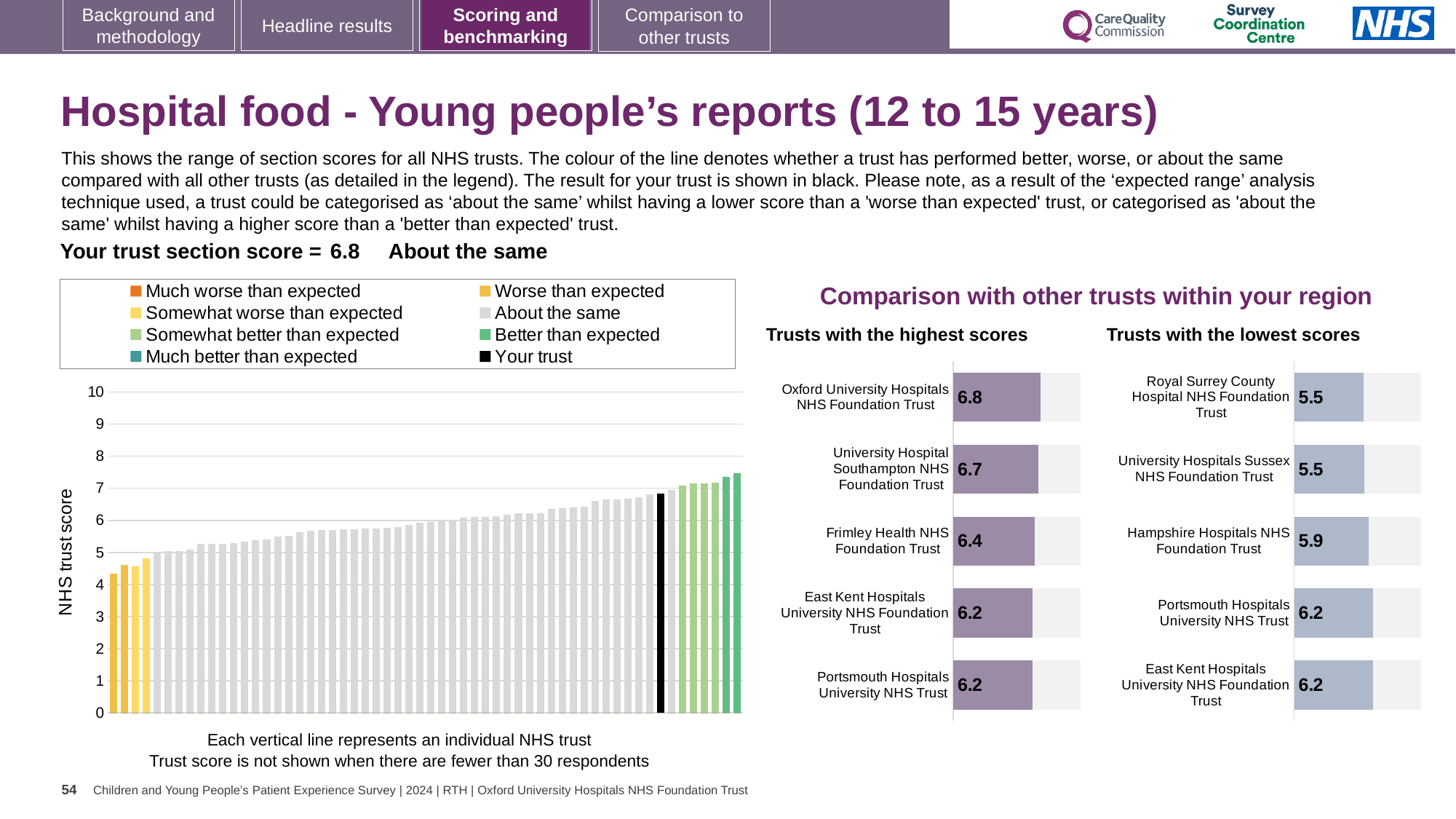
In the 'Trusts with the highest scores' chart, which trust has the highest score? Oxford University Hospitals NHS Foundation Trust How many trusts are shown in the 'Trusts with the lowest scores' chart? 5 In the NHS trust score chart on the left, is the value of the leftmost bar greater or less than 5? less In the 'Trusts with the lowest scores' chart, what is the difference between the scores of Hampshire Hospitals NHS Foundation Trust and Royal Surrey County Hospital NHS Foundation Trust? 0.4 What kind of chart is the NHS trust score chart on the left of the slide? Bar chart How many entries does the legend of the NHS trust score chart on the left list? 8 In the 'Trusts with the highest scores' chart, what is the difference between the scores of Oxford University Hospitals NHS Foundation Trust and Frimley Health NHS Foundation Trust? 0.4 In the NHS trust score chart on the left, what score does the black bar (your trust) represent? 6.8 In the 'Trusts with the highest scores' chart, which has the larger score: University Hospital Southampton NHS Foundation Trust or East Kent Hospitals University NHS Foundation Trust? University Hospital Southampton NHS Foundation Trust In the 'Trusts with the lowest scores' chart, what is the score for Hampshire Hospitals NHS Foundation Trust? 5.9 In the 'Trusts with the highest scores' chart, what is the score for Frimley Health NHS Foundation Trust? 6.4 In the NHS trust score chart on the left, do the bars rise or fall from left to right? Rise